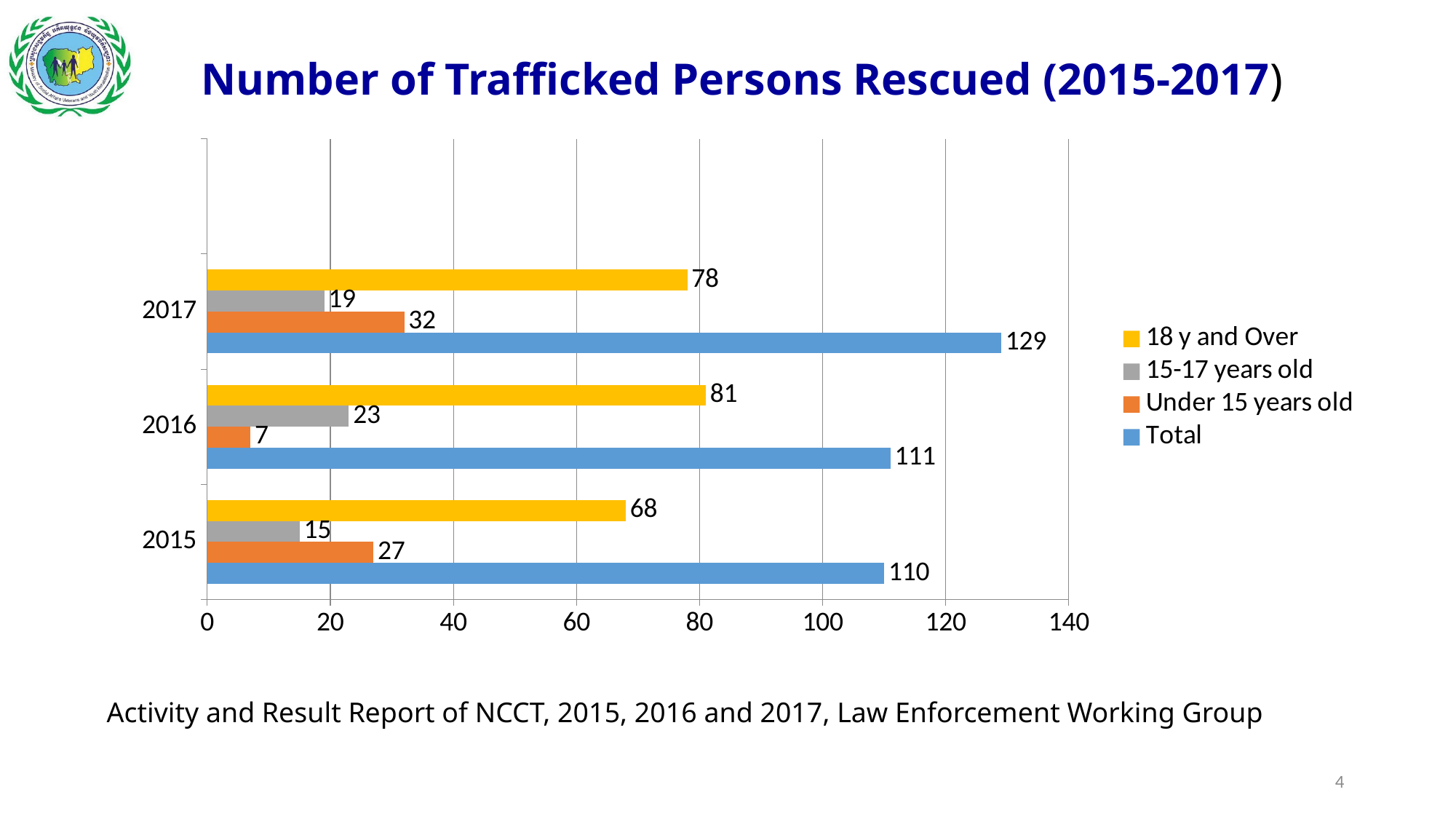
How many years are shown on the chart? 3 What is the value for 15-17 years old in 2017? 19 Which year has the highest Total? 2017 How many series does the legend list? 4 What kind of chart is shown on the slide? Bar chart What is the Total value for 2017? 129 What is the value for Under 15 years old in 2015? 27 Which is larger: the 18 y and Over value for 2016 or for 2017? 2016 Which year has the lowest value for Under 15 years old? 2016 What is the title of the chart? Number of Trafficked Persons Rescued (2015-2017) What is the difference between the Total for 2017 and the Total for 2016? 18 How many persons aged 18 y and Over were rescued in 2016? 81